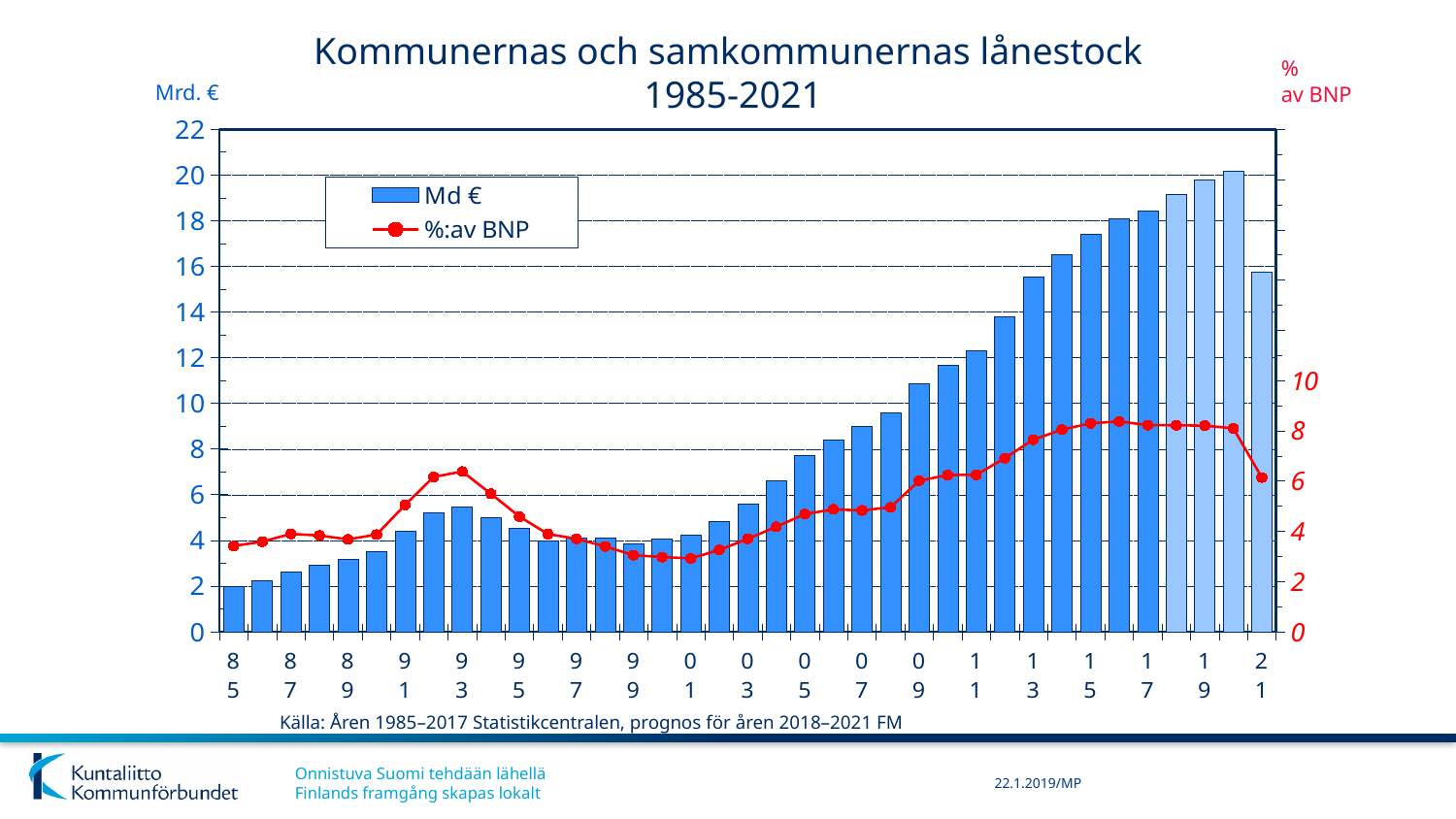
Is the Md € value for 1985 greater or less than 4? less What kind of chart is shown on the slide? A combined bar and line chart How many years (bars) are plotted in the chart? 37 Is the Md € value for 2021 greater or less than 18? less Which year has the larger Md € bar, 1993 or 1999? 1993 Is the Md € value for 2020 greater or less than 18? greater Which year has the tallest bar (Md €)? 2020 What are the two entries in the chart legend? Md € and %:av BNP What is the title of the chart? Kommunernas och samkommunernas lånestock 1985-2021 Which year has the shortest bar (Md €)? 1985 How many series does the legend list? 2